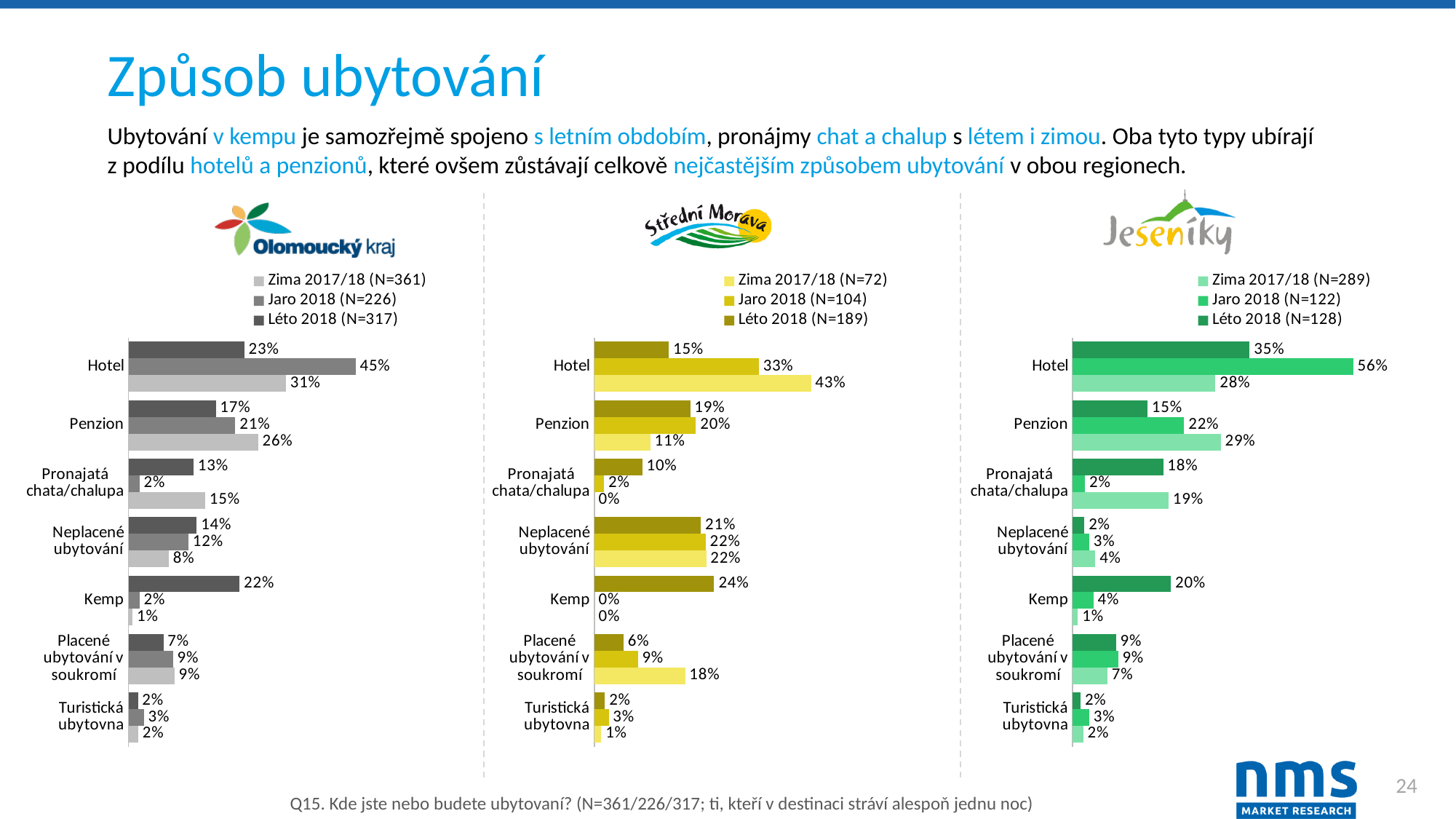
In the Střední Morava chart, what is the value for Kemp in the Léto 2018 series? 24% In the Olomoucký kraj chart, what is the difference between the Jaro 2018 and Léto 2018 values for Hotel? 22% How many series does the legend of the Olomoucký kraj chart list? 3 In the Olomoucký kraj chart, what is the value for Hotel in the Jaro 2018 series? 45% What is the sample size (N) for the Léto 2018 series in the Jeseníky chart legend? 128 In the Jeseníky chart, which is larger for Penzion: the Zima 2017/18 value or the Léto 2018 value? Zima 2017/18 In the Jeseníky chart, what is the value for Hotel in the Jaro 2018 series? 56% How many categories are shown on the Střední Morava chart? 7 What kind of chart is used for the Jeseníky data? Bar chart In the Střední Morava chart, which category has the highest value in the Zima 2017/18 series? Hotel In the Jeseníky chart, which category has the lowest value in the Zima 2017/18 series? Kemp In the Střední Morava chart, what is the value for Placené ubytování v soukromí in the Zima 2017/18 series? 18%